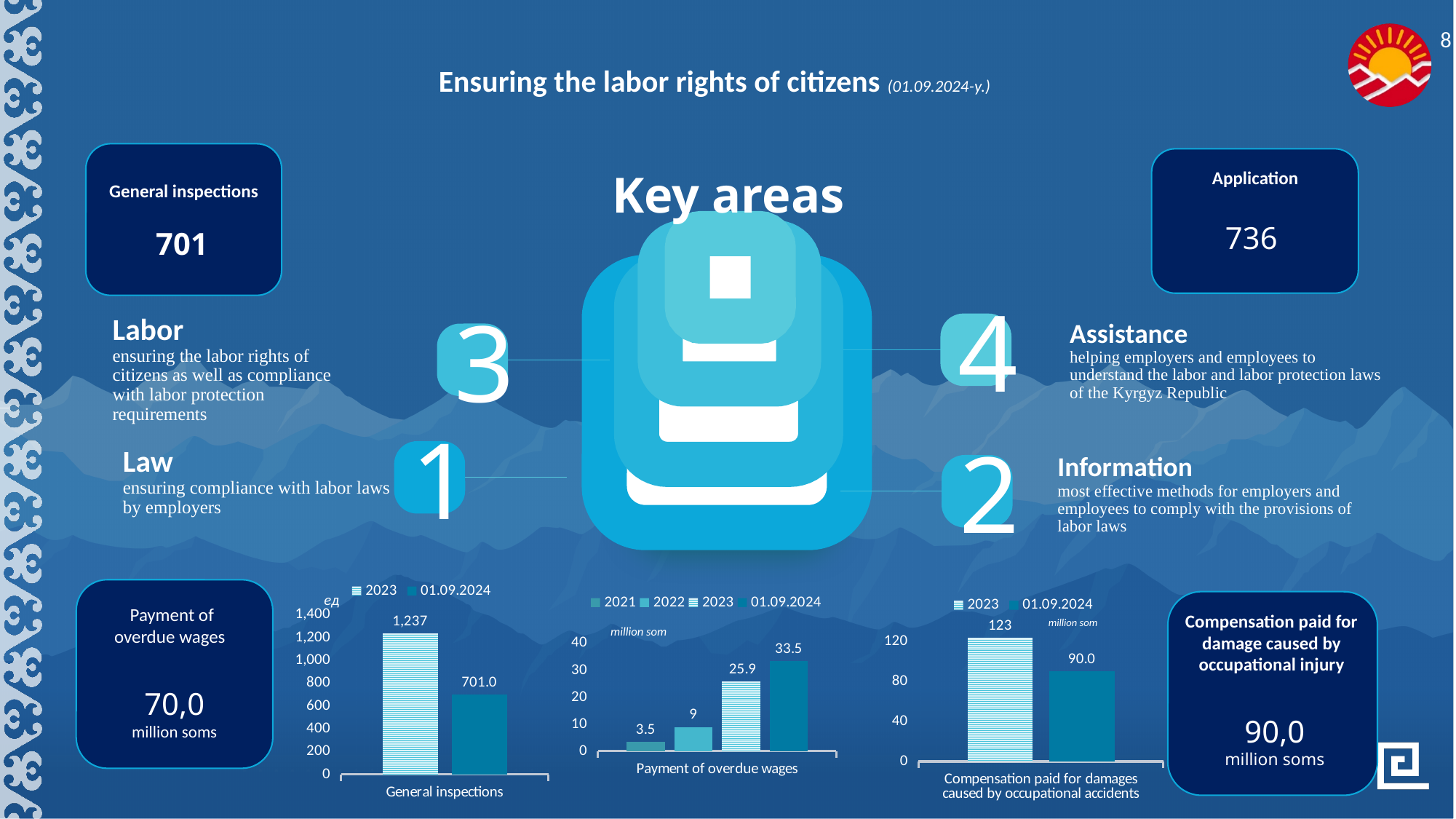
What kind of chart is the Compensation paid for damages caused by occupational accidents chart? bar chart In the Payment of overdue wages chart, how many series does the legend list? 4 In the Payment of overdue wages chart, what is the difference between the 2023 and 2022 values? 16.9 In the General inspections chart, what is the value for 01.09.2024? 701.0 In the Payment of overdue wages chart, do the values rise or fall from 2021 to 01.09.2024? rise In the General inspections chart, how many series does the legend list? 2 In the Payment of overdue wages chart, what is the value for 2022? 9 In the General inspections chart, what is the value for 2023? 1,237 In the Compensation paid for damages caused by occupational accidents chart, which is larger, 2023 or 01.09.2024? 2023 In the Compensation paid for damages caused by occupational accidents chart, what is the value for 2023? 123 In the Payment of overdue wages chart, what is the value for 01.09.2024? 33.5 In the Payment of overdue wages chart, which series has the lowest value? 2021